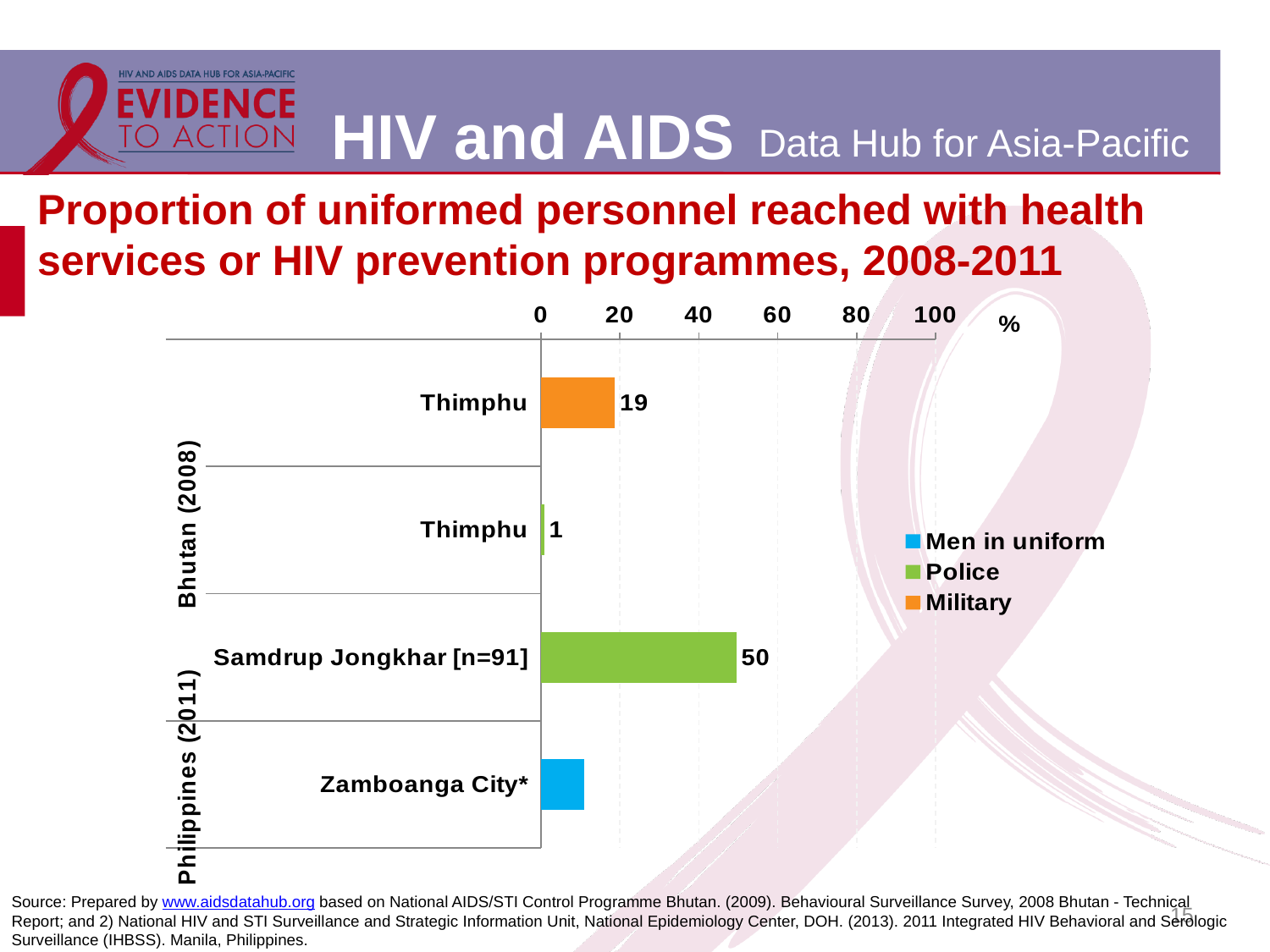
What is the value of the orange Military bar for Thimphu? 19 Which colour represents Police in the legend? green Which category has the highest value? Samdrup Jongkhar [n=91] How many series does the legend list? 3 What is the difference between the value for Samdrup Jongkhar [n=91] and the Military value for Thimphu? 31 What is the value of the green Police bar for Thimphu? 1 What kind of chart is shown on the slide? bar chart What is the value for Samdrup Jongkhar [n=91]? 50 Which is larger: the Military value for Thimphu or the value for Samdrup Jongkhar [n=91]? Samdrup Jongkhar [n=91] Which bar has the lowest value? Thimphu (Police) How many bars are plotted in the chart? 4 Is the value for Zamboanga City* greater or less than 20? less